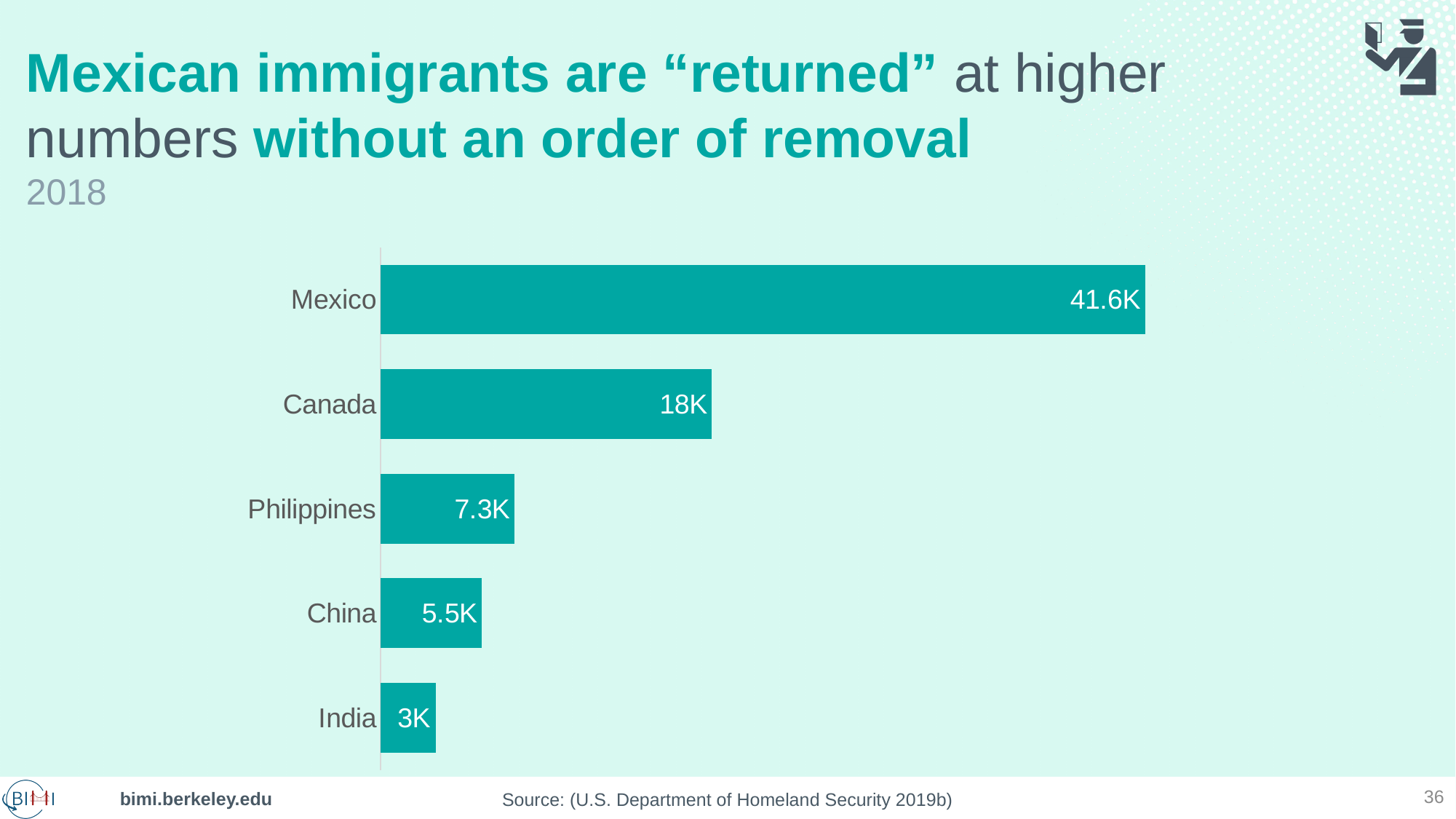
Which has a larger value, the Philippines or China? Philippines What is the value for Canada? 18K What is the difference between the values for Mexico and Canada? 23.6K What is the value for the Philippines? 7.3K What is the difference between the values for China and India? 2.5K What is the value for India? 3K How many countries are shown in the chart? 5 What kind of chart is shown on the slide? Bar chart What is the value for China? 5.5K Which country has the lowest value? India Which country has the highest value? Mexico What is the value for Mexico? 41.6K